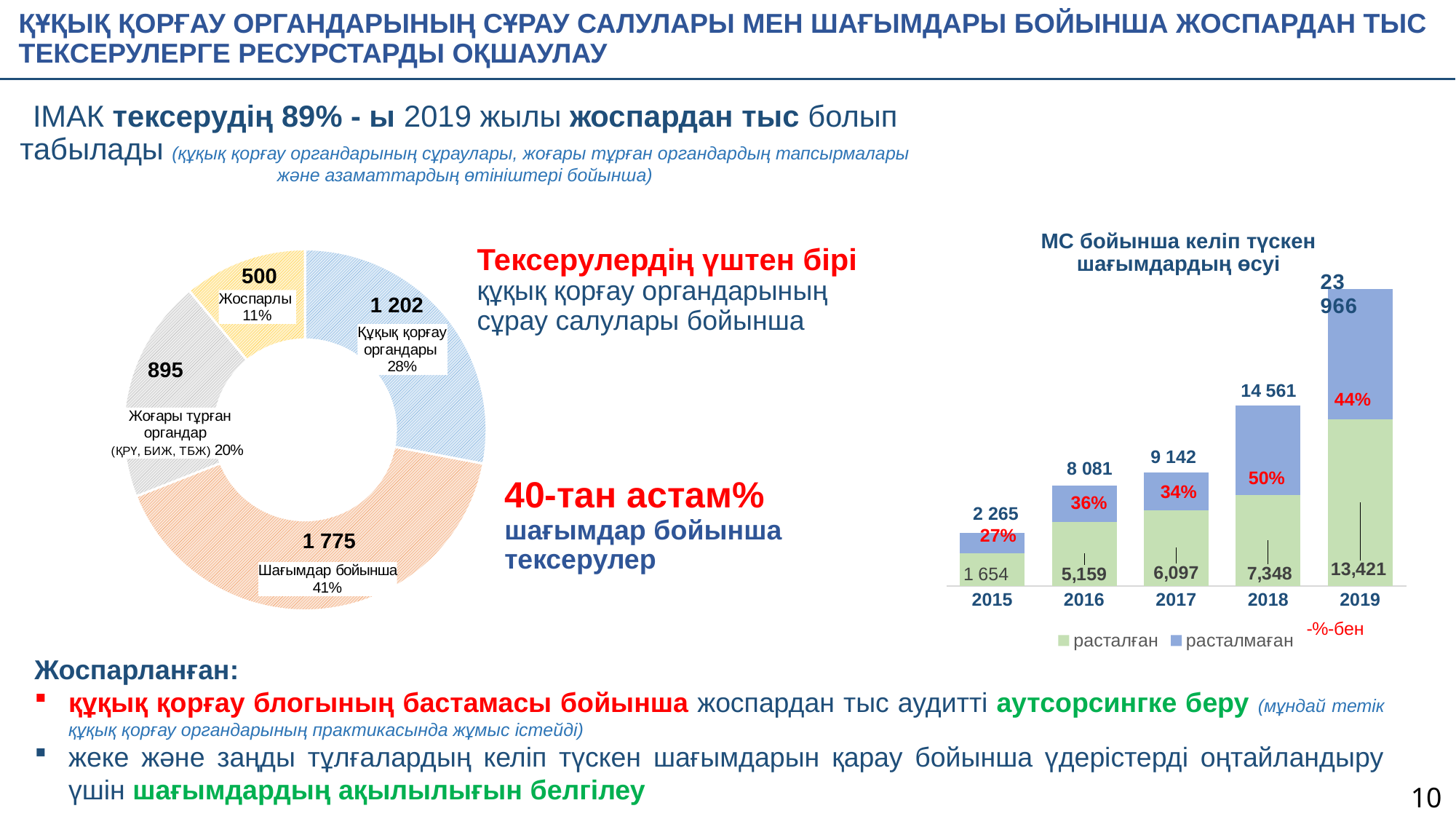
In the chart 'МС бойынша келіп түскен шағымдардың өсуі', what is the 'расталған' value for 2019? 13,421 In the donut chart on the left, which segment has the largest value? Шағымдар бойынша How many series does the legend of the chart 'МС бойынша келіп түскен шағымдардың өсуі' list? 2 In the donut chart on the left, which segment has the smallest value? Жоспарлы In the donut chart on the left, what is the value for the 'Шағымдар бойынша' segment? 1 775 How many segments does the donut chart on the left have? 4 In the chart 'МС бойынша келіп түскен шағымдардың өсуі', do the bar totals rise or fall from 2015 to 2019? rise In the chart 'МС бойынша келіп түскен шағымдардың өсуі', what is the total value of the bar for 2018? 14 561 In the chart 'МС бойынша келіп түскен шағымдардың өсуі', what percentage is shown on the 2017 bar? 34% In the donut chart on the left, what is the difference between the 'Құқық қорғау органдары' value and the 'Жоғары тұрған органдар' value? 307 What kind of chart is 'МС бойынша келіп түскен шағымдардың өсуі'? stacked bar chart In the donut chart on the left, what percentage share does the 'Жоспарлы' segment have? 11%